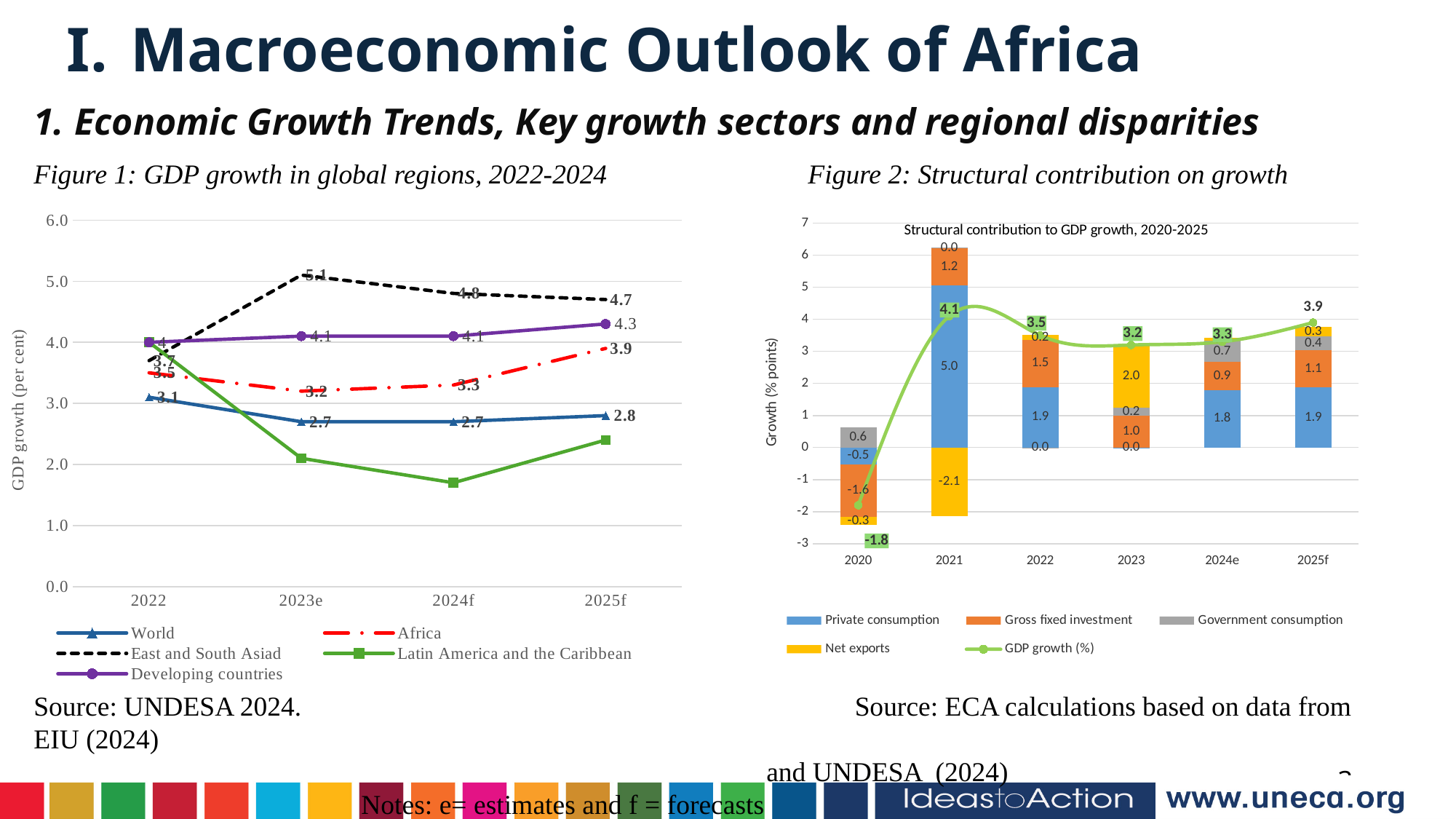
In Figure 1 (GDP growth in global regions), what is the difference between Africa and World in 2025f? 1.1 In Figure 1 (GDP growth in global regions), how many series does the legend list? 5 In Figure 2 (Structural contribution on growth), which is larger, GDP growth (%) in 2022 or in 2025f? 2025f What kind of chart is Figure 1 (GDP growth in global regions)? Line chart In Figure 2 (Structural contribution on growth), what is the GDP growth (%) value for 2020? -1.8 In Figure 1 (GDP growth in global regions), what is the value for East and South Asia in 2023e? 5.1 In Figure 2 (Structural contribution on growth), which year has the lowest GDP growth (%)? 2020 In Figure 2 (Structural contribution on growth), what is the Private consumption contribution in 2021? 5.0 In Figure 1 (GDP growth in global regions), which series has the highest value in 2024f? East and South Asia In Figure 1 (GDP growth in global regions), is the value for Latin America and the Caribbean in 2024f greater or less than 2.0? less In Figure 1 (GDP growth in global regions), what is the value for World in 2025f? 2.8 In Figure 2 (Structural contribution on growth), how many years are shown on the x axis? 6